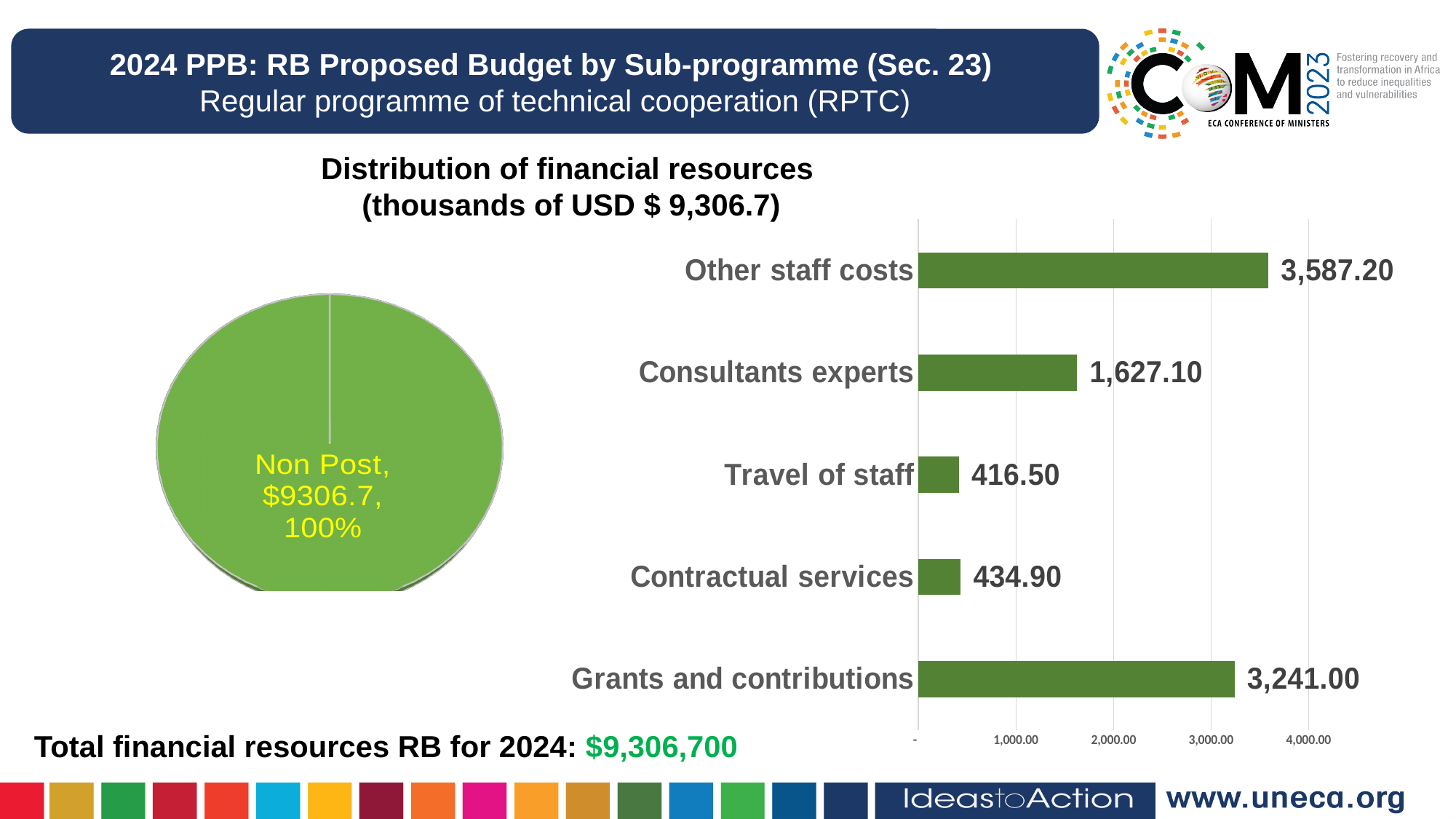
In the bar chart on the right, how many categories are shown? 5 In the bar chart on the right, what is the difference between Other staff costs and Grants and contributions? 346.20 In the bar chart on the right, what is the value for Other staff costs? 3,587.20 In the bar chart on the right, which category has the highest value? Other staff costs In the bar chart on the right, what is the value for Grants and contributions? 3,241.00 In the bar chart on the right, what is the value for Consultants experts? 1,627.10 What is the title of the pie chart on the left? Distribution of financial resources (thousands of USD $ 9,306.7) In the pie chart on the left, what share does the Non Post slice represent? 100% In the bar chart on the right, what is the value for Travel of staff? 416.50 What kind of chart is on the right side of the slide? Bar chart In the bar chart on the right, which is larger: Contractual services or Travel of staff? Contractual services In the bar chart on the right, which category has the lowest value? Travel of staff